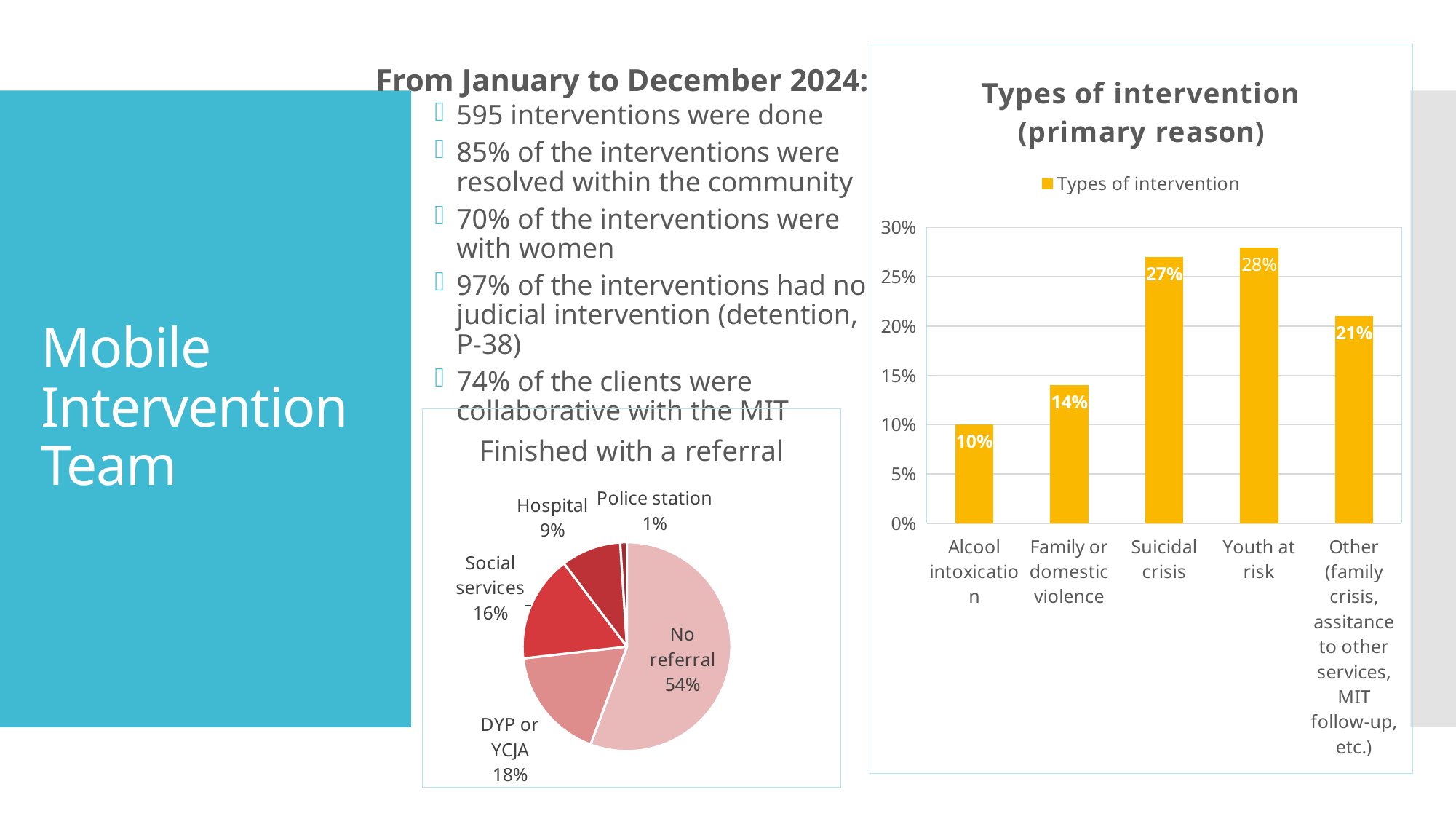
In the 'Types of intervention (primary reason)' chart, what is the difference between Youth at risk and Alcool intoxication? 18% What kind of chart is 'Finished with a referral'? Pie chart What kind of chart is 'Types of intervention (primary reason)'? Bar chart In the 'Finished with a referral' chart, which slice is the smallest? Police station In the 'Finished with a referral' chart, what share does No referral have? 54% In the 'Types of intervention (primary reason)' chart, how many series does the legend list? 1 In the 'Finished with a referral' chart, what is the value for Social services? 16% In the 'Types of intervention (primary reason)' chart, what is the value for Suicidal crisis? 27% In the 'Types of intervention (primary reason)' chart, what is the value for Family or domestic violence? 14% In the 'Types of intervention (primary reason)' chart, how many categories are shown? 5 In the 'Types of intervention (primary reason)' chart, which category has the highest value? Youth at risk In the 'Types of intervention (primary reason)' chart, which category has the lowest value? Alcool intoxication